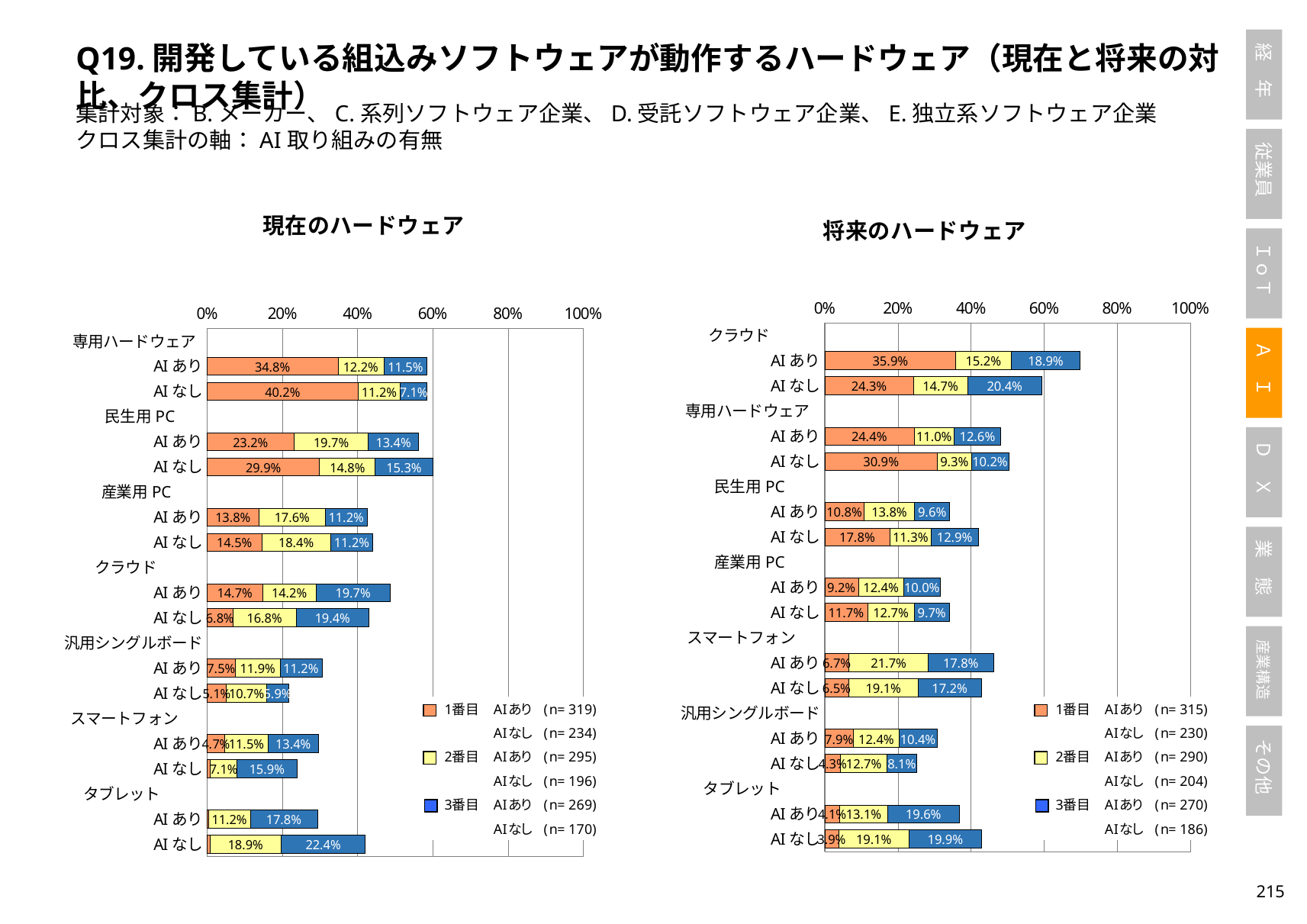
In the 現在のハードウェア chart, which category has the highest 1番目 value? 専用ハードウェア AIなし In the 将来のハードウェア chart, what is the 1番目 value for クラウド AIあり? 35.9% In the 現在のハードウェア chart legend, what is the n for 1番目 AIあり? 319 In the 将来のハードウェア chart, which is larger: the 1番目 value for 専用ハードウェア AIなし or for 専用ハードウェア AIあり? 専用ハードウェア AIなし In the 現在のハードウェア chart, what is the 1番目 value for 専用ハードウェア AIあり? 34.8% In the 現在のハードウェア chart, what is the 3番目 value for クラウド AIあり? 19.7% In the 現在のハードウェア chart, what is the difference between the 1番目 values for 専用ハードウェア AIなし and 専用ハードウェア AIあり? 5.4% What kind of chart is the 将来のハードウェア chart? stacked bar chart In the 将来のハードウェア chart, what is the 2番目 value for スマートフォン AIあり? 21.7% In the 将来のハードウェア chart, is the total stacked bar for クラウド AIあり greater or less than 60%? greater How many series does the legend of the 現在のハードウェア chart list? 3 In the 将来のハードウェア chart, what is the total of the stacked bar for クラウド AIあり? 70.0%